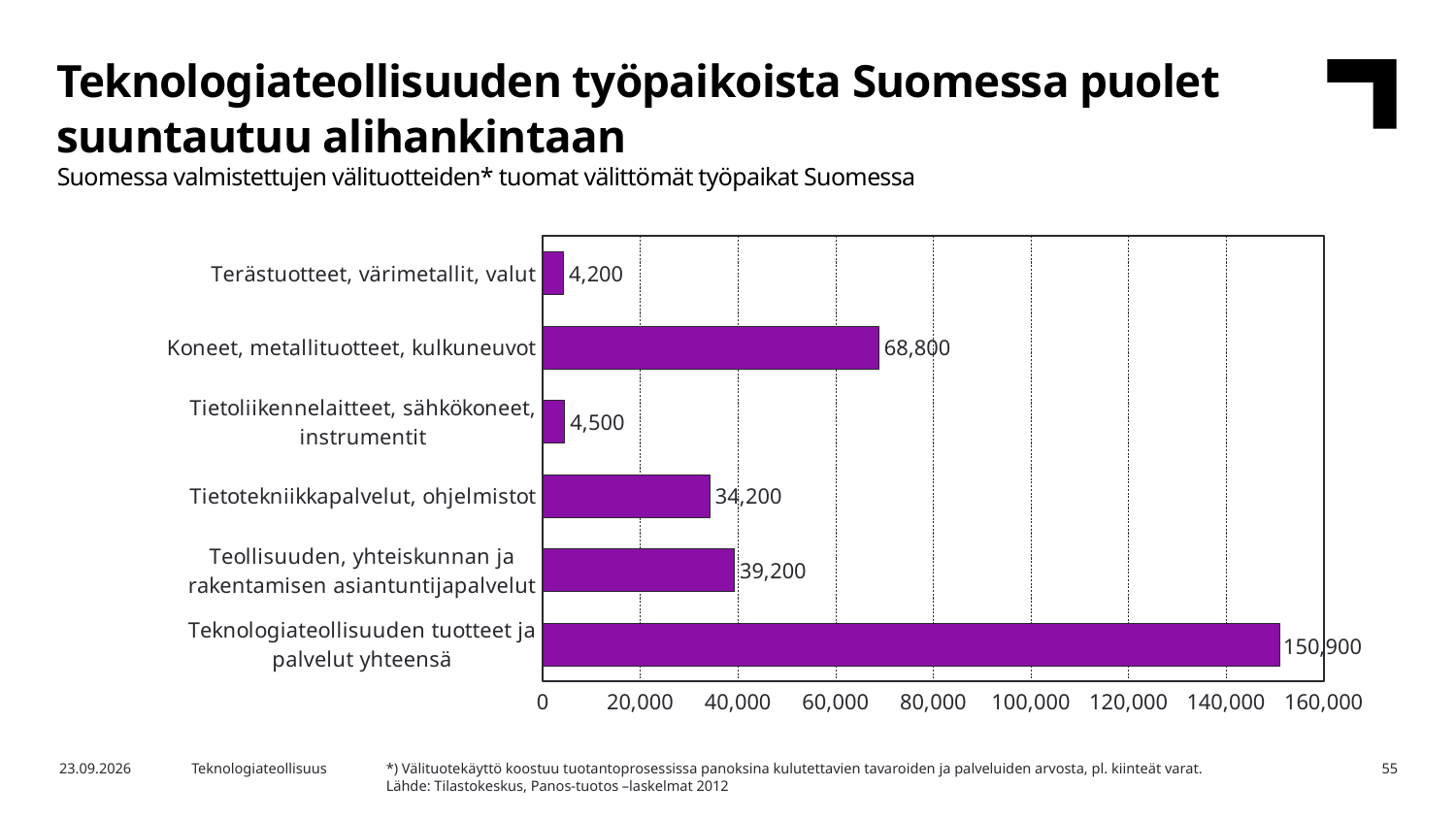
How many categories are shown in the chart? 6 What is the difference between Tietoliikennelaitteet, sähkökoneet, instrumentit and Terästuotteet, värimetallit, valut? 300 What is the value for Teknologiateollisuuden tuotteet ja palvelut yhteensä? 150,900 Is the value for Koneet, metallituotteet, kulkuneuvot greater or less than 60,000? greater What kind of chart is shown on the slide? bar chart What is the value for Koneet, metallituotteet, kulkuneuvot? 68,800 Which category has the lowest value? Terästuotteet, värimetallit, valut Which is larger: Koneet, metallituotteet, kulkuneuvot or Tietoliikennelaitteet, sähkökoneet, instrumentit? Koneet, metallituotteet, kulkuneuvot Which category has the highest value? Teknologiateollisuuden tuotteet ja palvelut yhteensä What is the difference between Teollisuuden, yhteiskunnan ja rakentamisen asiantuntijapalvelut and Tietotekniikkapalvelut, ohjelmistot? 5,000 What is the value for Terästuotteet, värimetallit, valut? 4,200 What is the value for Tietotekniikkapalvelut, ohjelmistot? 34,200